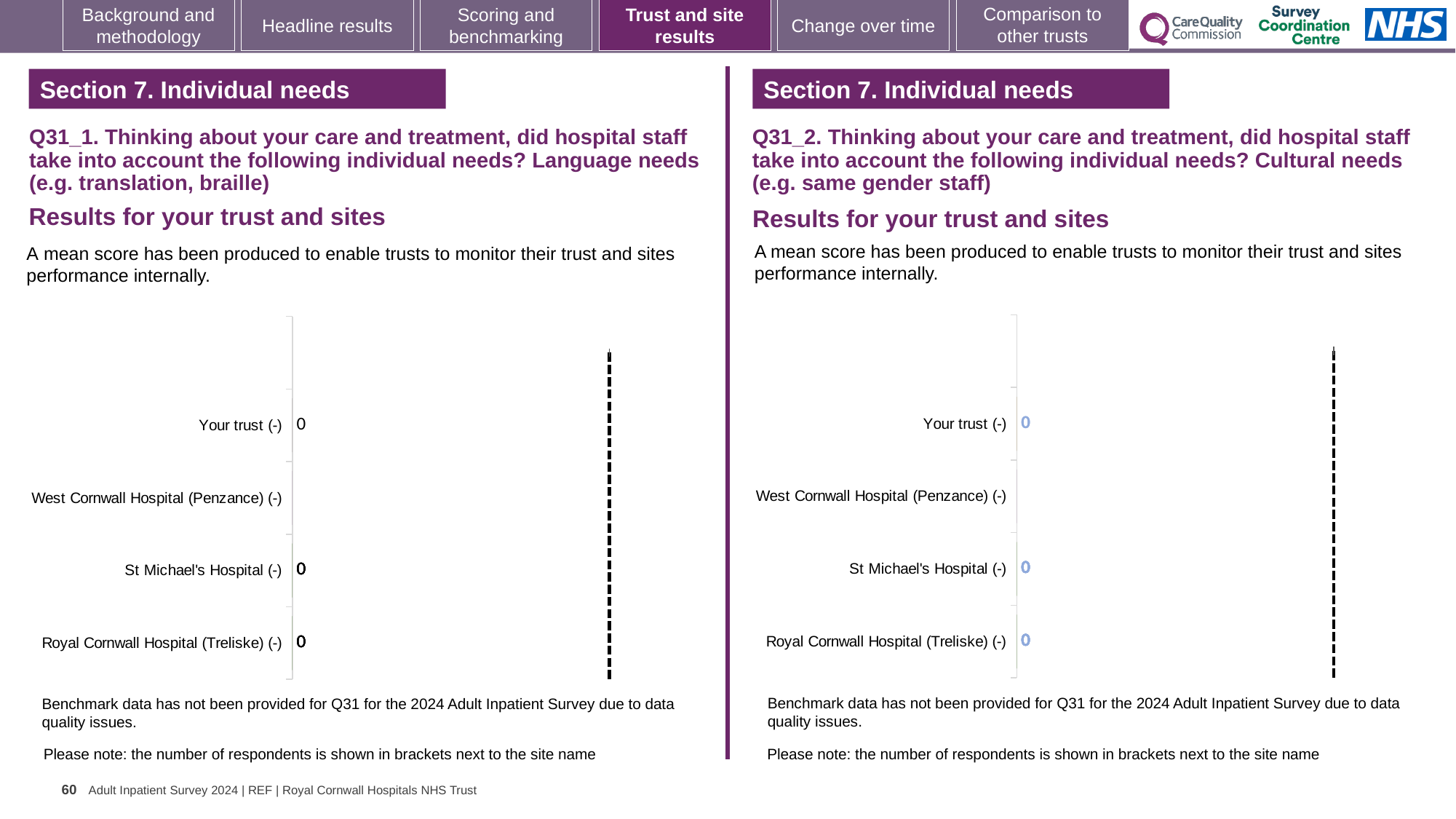
On the right chart (Q31_2, Cultural needs), how many categories are listed on the vertical axis? 4 On the left chart (Q31_1, Language needs), what is the value shown for Royal Cornwall Hospital (Treliske)? 0 On the left chart (Q31_1, Language needs), how many categories are listed on the vertical axis? 4 On the right chart (Q31_2, Cultural needs), what is the value shown for St Michael's Hospital? 0 What kind of chart is the left chart (Q31_1, Language needs)? bar chart On the right chart (Q31_2, Cultural needs), what is the difference between the value for Your trust and the value for Royal Cornwall Hospital (Treliske)? 0 On the left chart (Q31_1, Language needs), what is the value shown for St Michael's Hospital? 0 On the left chart (Q31_1, Language needs), what is the value shown for Your trust? 0 On the left chart (Q31_1, Language needs), which category has no data label shown? West Cornwall Hospital (Penzance) On the right chart (Q31_2, Cultural needs), what is shown in brackets next to the site name for Your trust? - On the right chart (Q31_2, Cultural needs), what is the value shown for Royal Cornwall Hospital (Treliske)? 0 On the right chart (Q31_2, Cultural needs), what is the value shown for Your trust? 0